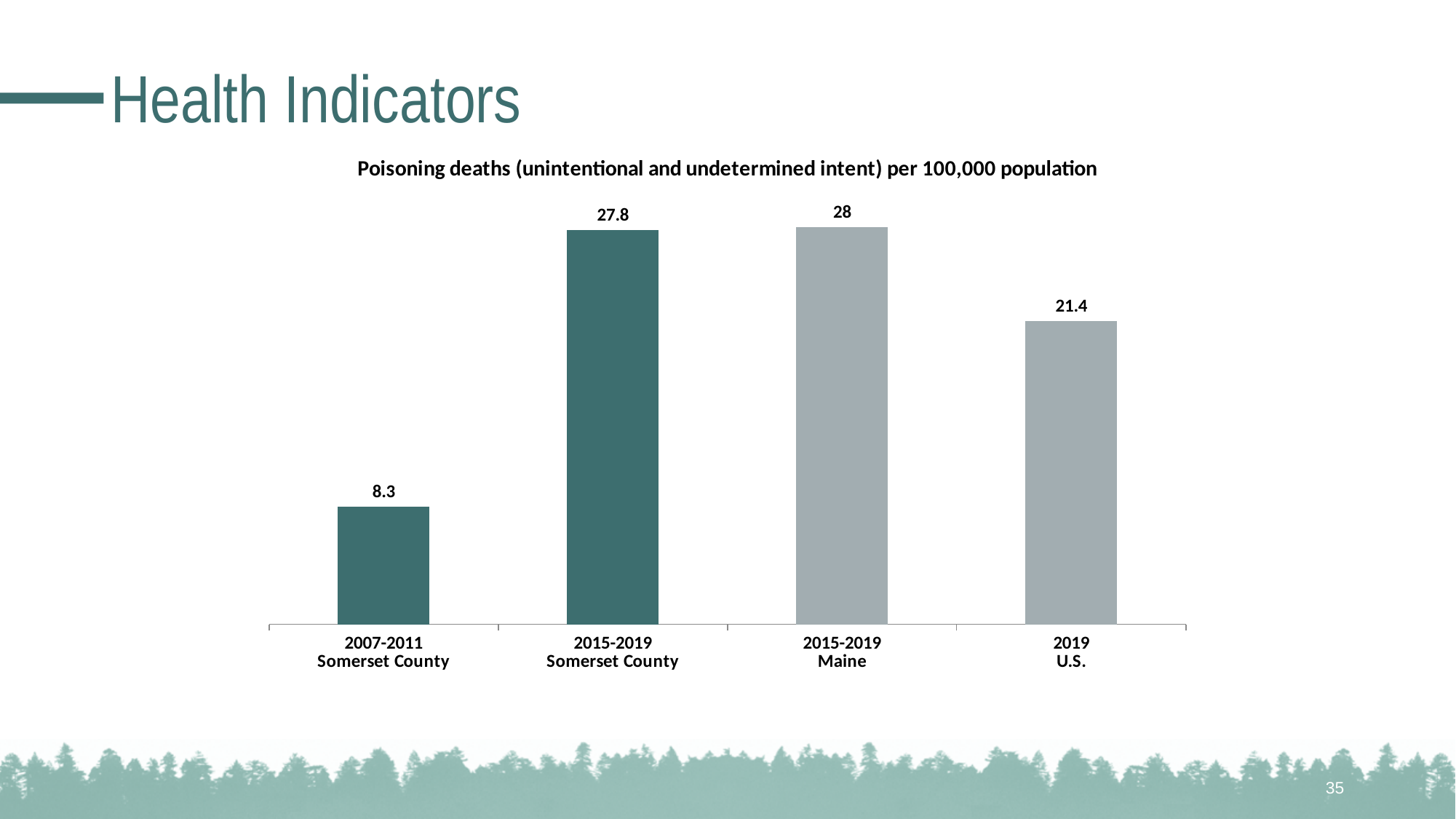
What type of chart is shown on the slide? Bar chart What is the difference between the 2015-2019 Somerset County rate and the 2019 U.S. rate? 6.4 What is the title of the chart? Poisoning deaths (unintentional and undetermined intent) per 100,000 population Which category has the lowest poisoning death rate? 2007-2011 Somerset County What is the poisoning death rate per 100,000 population for Somerset County in 2007-2011? 8.3 Which is larger, the 2015-2019 Somerset County rate or the 2019 U.S. rate? 2015-2019 Somerset County What is the poisoning death rate per 100,000 population for Maine in 2015-2019? 28 Which category has the highest poisoning death rate? 2015-2019 Maine By how much did the Somerset County poisoning death rate increase from 2007-2011 to 2015-2019? 19.5 How many bars are shown in the chart? 4 What is the poisoning death rate per 100,000 population for the U.S. in 2019? 21.4 What is the poisoning death rate per 100,000 population for Somerset County in 2015-2019? 27.8